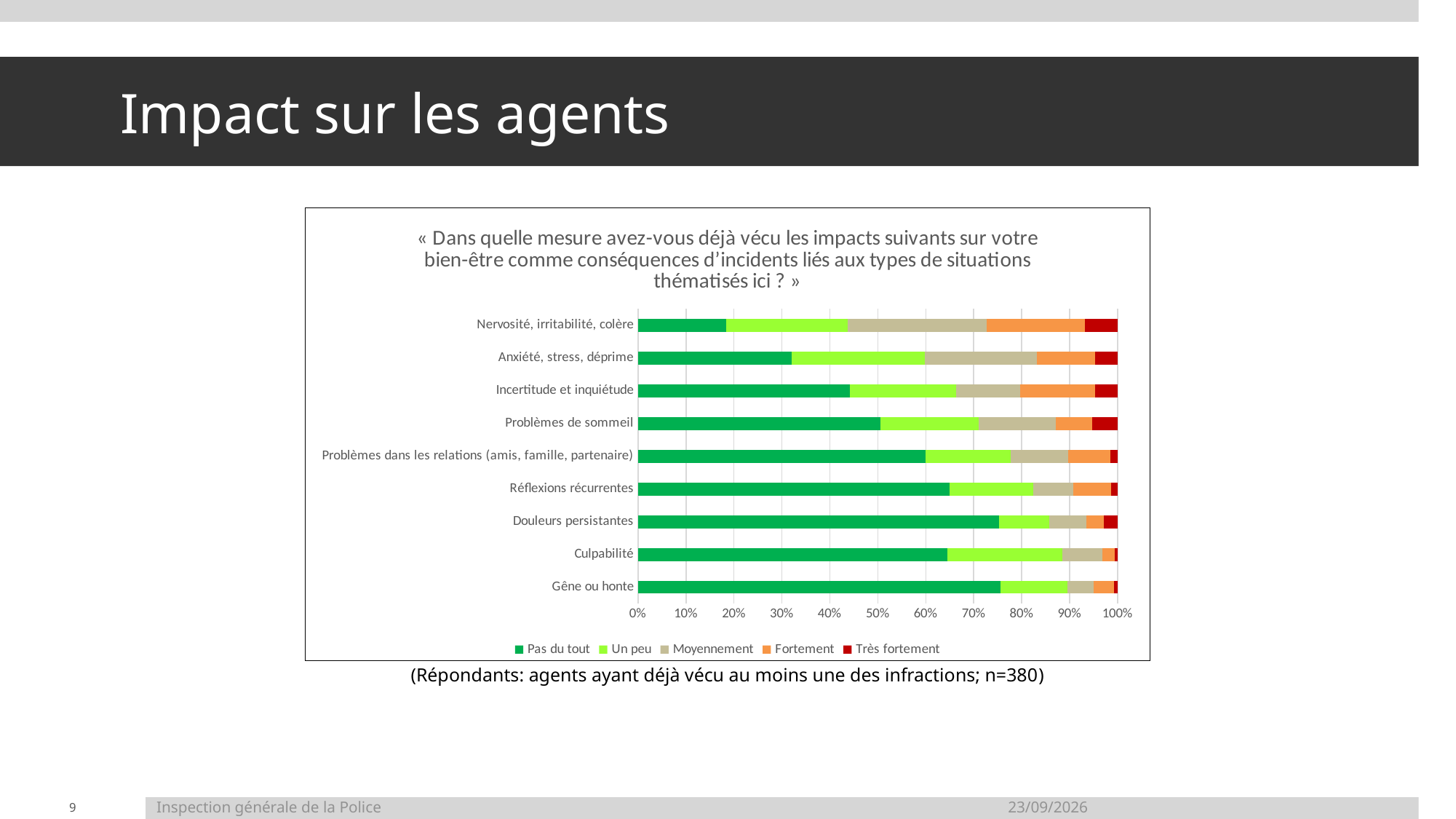
What kind of chart is shown on the slide? Stacked bar chart Is the 'Pas du tout' share for 'Douleurs persistantes' greater or less than 70%? greater Which has a larger 'Pas du tout' share: 'Incertitude et inquiétude' or 'Gêne ou honte'? Gêne ou honte Which series is listed first in the chart legend? Pas du tout How many series does the chart legend list? 5 Is the 'Pas du tout' share for 'Nervosité, irritabilité, colère' greater or less than 20%? less Which category has the lowest share of 'Pas du tout' responses? Nervosité, irritabilité, colère Is the 'Pas du tout' share for 'Réflexions récurrentes' greater or less than 60%? greater Which has a larger 'Pas du tout' share: 'Nervosité, irritabilité, colère' or 'Anxiété, stress, déprime'? Anxiété, stress, déprime How many categories (impact types) are listed on the chart? 9